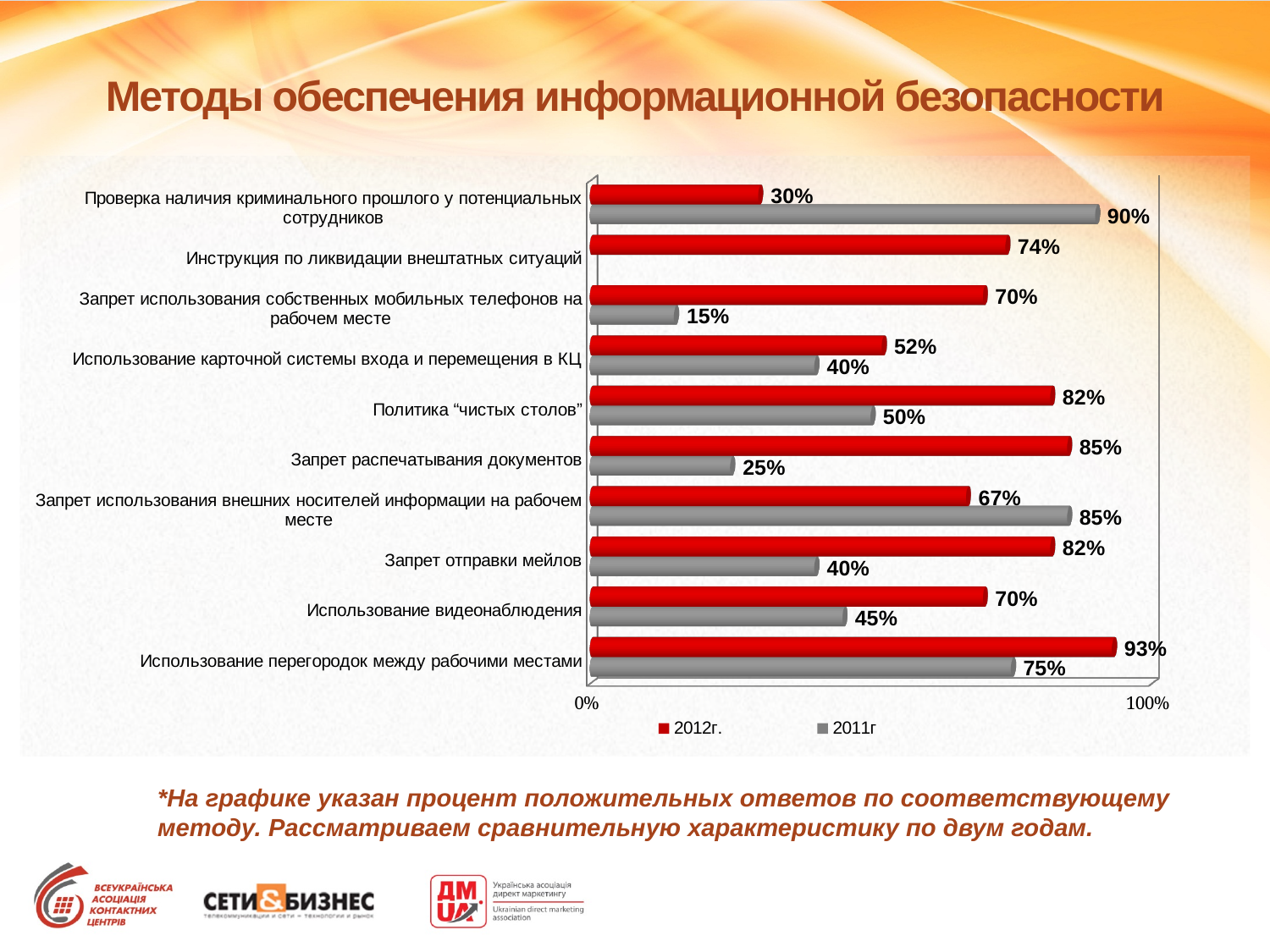
What is the title of the chart on the slide? Методы обеспечения информационной безопасности Which colour represents the 2012 series in the chart? Red What is the 2011 value for "Запрет распечатывания документов"? 25% Which category has the highest 2012 value? Использование перегородок между рабочими местами How many series does the legend list? 2 What is the 2011 value for "Проверка наличия криминального прошлого у потенциальных сотрудников"? 90% For "Запрет использования внешних носителей информации на рабочем месте", which year has the larger value, 2012 or 2011? 2011 Which category has the lowest 2011 value? Запрет использования собственных мобильных телефонов на рабочем месте What type of chart is shown on the slide? Bar chart How many categories are shown on the chart? 10 What is the difference between the 2012 and 2011 values for "Запрет отправки мейлов"? 42% What is the 2012 value for "Использование перегородок между рабочими местами"? 93%